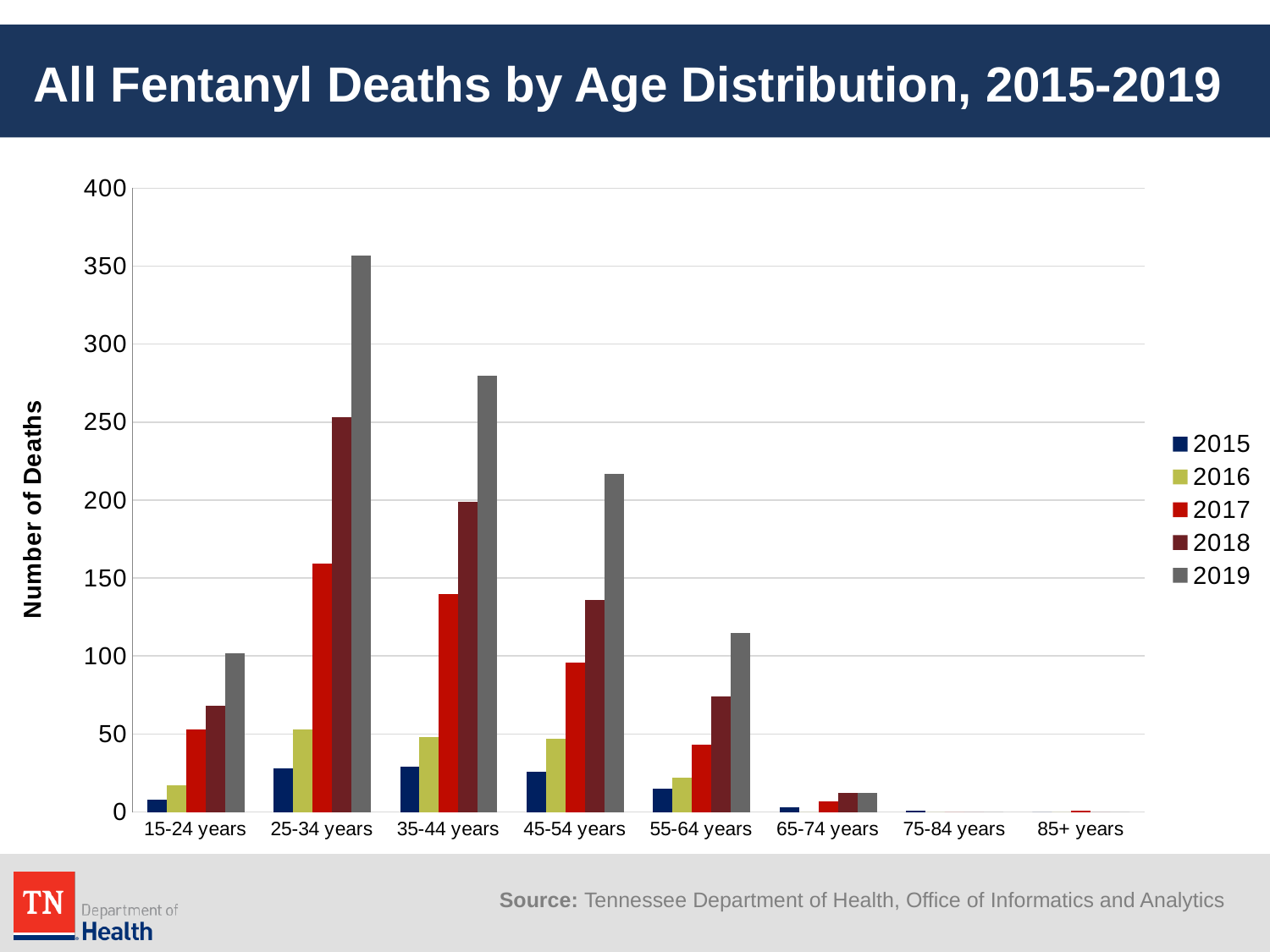
For the 2019 series, do the values rise or fall from 25-34 years through 85+ years? fall Is the value for 45-54 years in 2019 greater or less than 200? greater Is the value for 35-44 years in 2017 greater or less than 150? less How many age groups are shown on the x axis? 8 What kind of chart is shown on the slide? bar chart What is the title of the y axis? Number of Deaths Is the value for 25-34 years in 2019 greater or less than 300? greater Which age group has the highest number of fentanyl deaths in 2019? 25-34 years Which is larger: the 2017 value for 25-34 years or the 2018 value for 45-54 years? 2017 value for 25-34 years How many series does the legend list? 5 Which year has the highest number of deaths in the 35-44 years age group? 2019